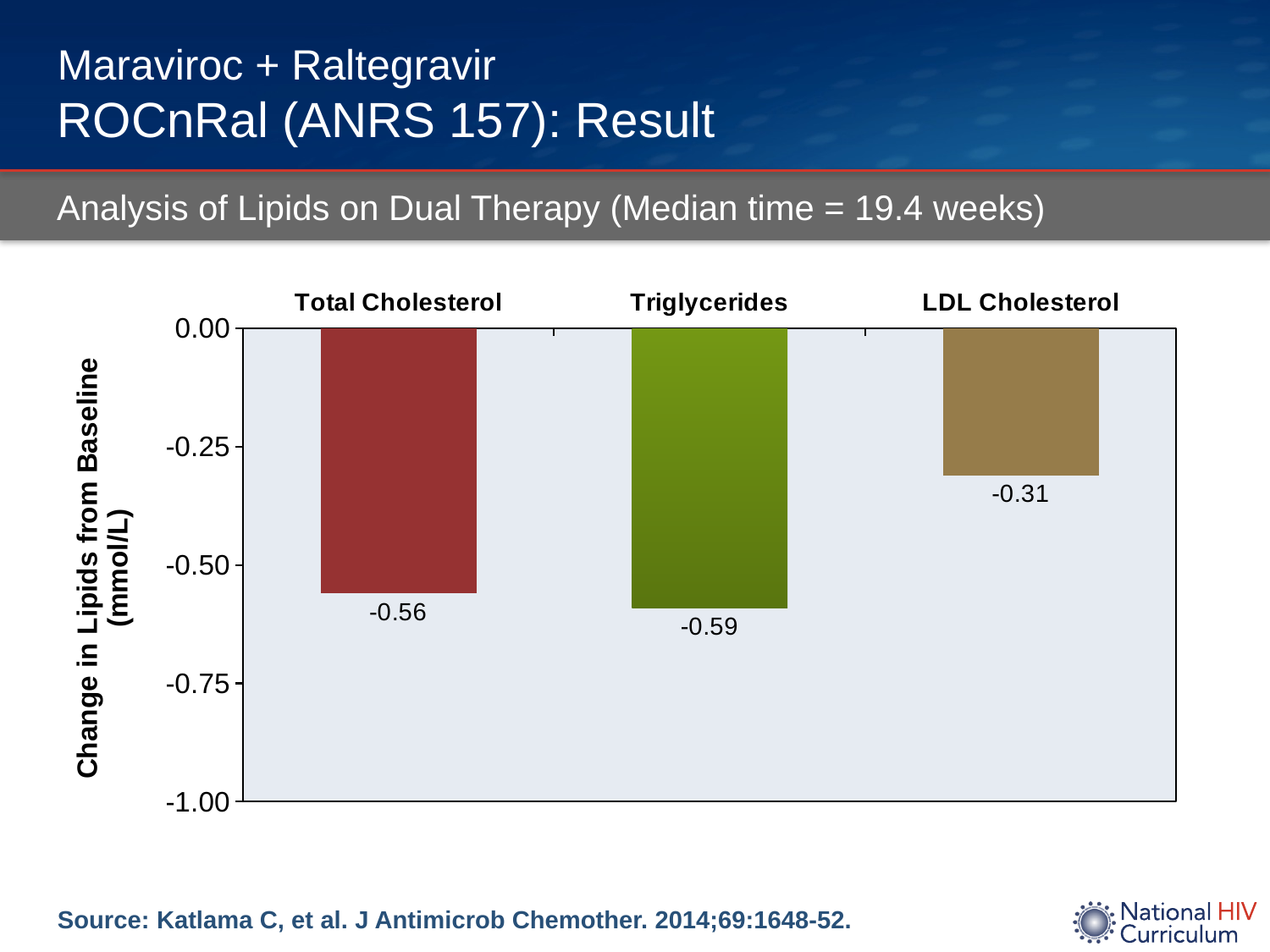
What is the change in lipids from baseline for Triglycerides? -0.59 What kind of chart is shown on the slide? bar chart Which lipid measure shows the largest decrease from baseline? Triglycerides Which lipid measure shows the smallest decrease from baseline? LDL Cholesterol What is the difference between the change for Total Cholesterol and the change for LDL Cholesterol? 0.25 What is the difference between the change for Triglycerides and the change for LDL Cholesterol? 0.28 What is the change in lipids from baseline for LDL Cholesterol? -0.31 What is the label of the vertical axis of the chart? Change in Lipids from Baseline (mmol/L) What is the change in lipids from baseline for Total Cholesterol? -0.56 Which decreased more from baseline, Total Cholesterol or LDL Cholesterol? Total Cholesterol How many lipid categories are plotted in the chart? 3 Is the value for LDL Cholesterol greater or less than -0.25? less